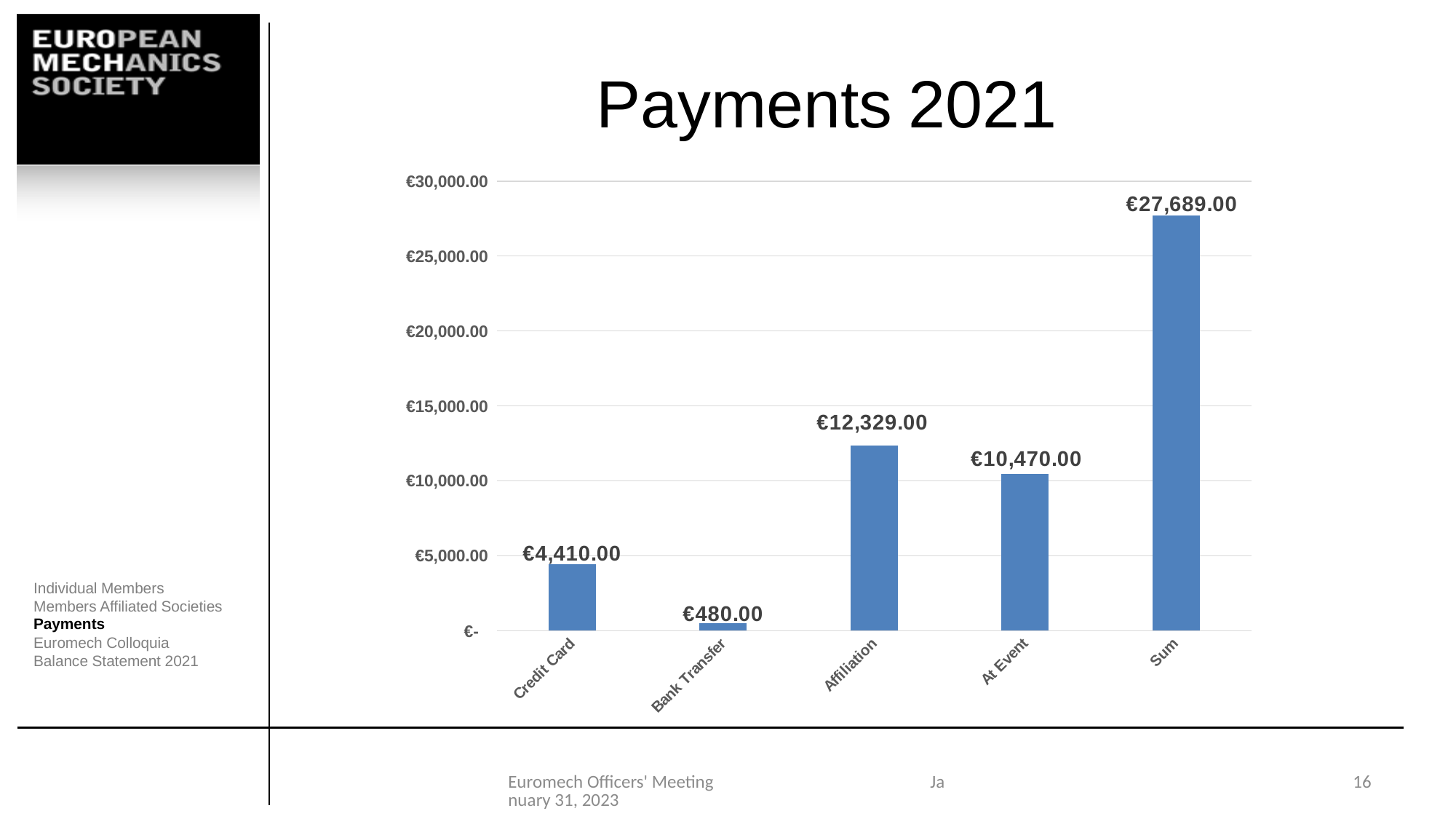
What kind of chart is shown on the slide? Bar chart What is the value for Credit Card? €4,410.00 Which category has the lowest value? Bank Transfer How many categories are shown on the x axis? 5 Which is larger, the value for Credit Card or the value for Bank Transfer? Credit Card Is the value for At Event greater or less than €10,000.00? greater What is the value for Sum? €27,689.00 What is the value for At Event? €10,470.00 What is the value for Bank Transfer? €480.00 What is the value for Affiliation? €12,329.00 Excluding Sum, which payment category has the highest value? Affiliation What is the difference between the values for Affiliation and At Event? €1,859.00